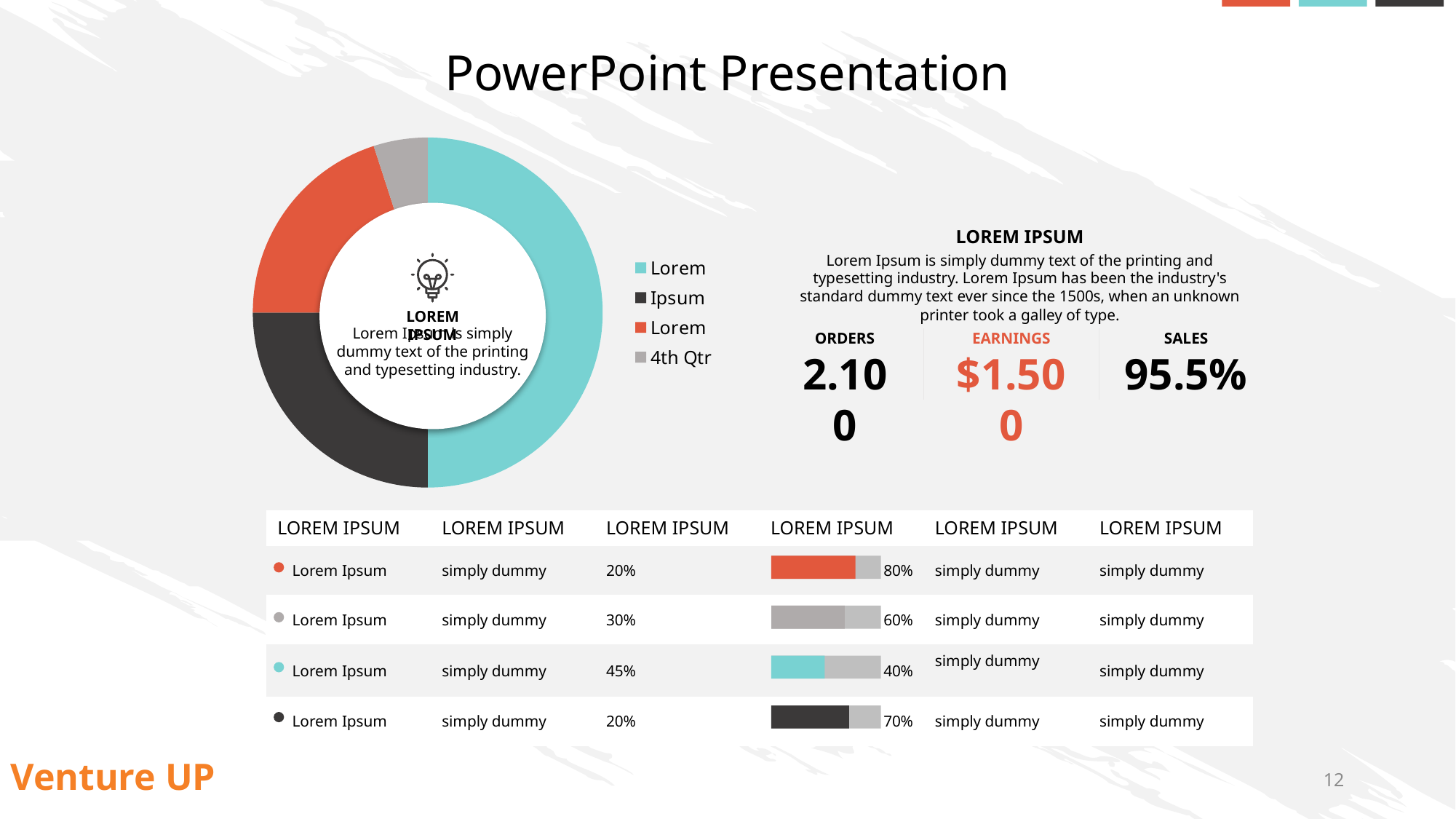
Which legend entry corresponds to the smallest slice of the doughnut chart? 4th Qtr What is the last entry listed in the legend of the doughnut chart? 4th Qtr What colour is the slice labelled 4th Qtr in the doughnut chart? Grey In the table's bar column, which row has the highest percentage? The first row, 80% Which slice of the doughnut chart is larger, the teal slice or the grey slice? The teal slice How many entries does the legend of the doughnut chart list? 4 What kind of chart is shown on the left of the slide? Doughnut chart What is the difference between the highest and lowest percentages shown in the table's bar column? 40% How many slices does the doughnut chart have? 4 In the table's bar column, which is larger, the value in the second row or the value in the fourth row? The fourth row (70%) In the table's bar column, which row has the lowest percentage? The third row, 40% What colour is the largest slice of the doughnut chart? Teal